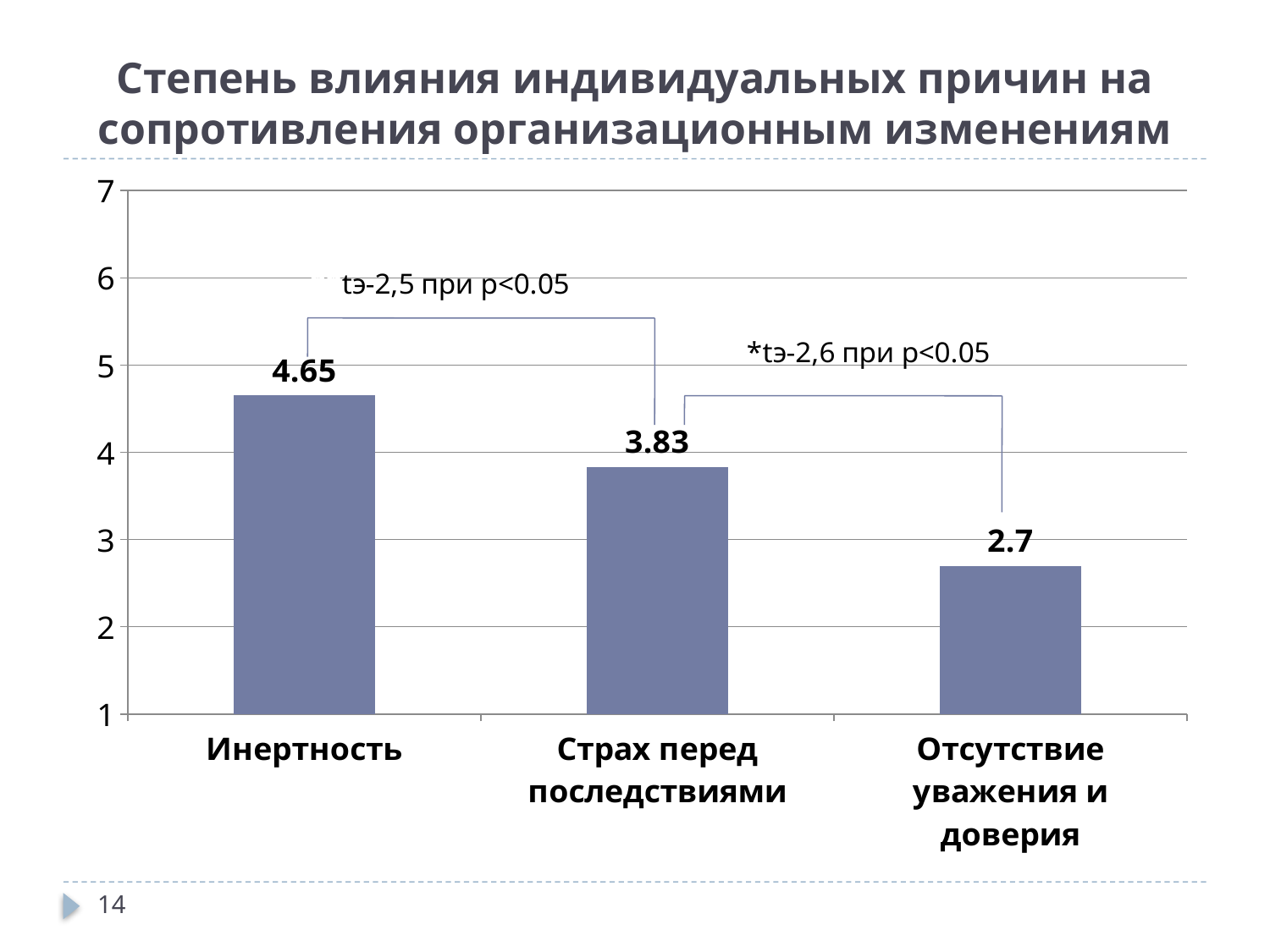
Is the value for Страх перед последствиями greater or less than 4? less How many categories are shown in the chart? 3 Which category has the lowest value? Отсутствие уважения и доверия Which category has the highest value? Инертность What is the value for Инертность? 4.65 What is the value for Отсутствие уважения и доверия? 2.7 What is the value for Страх перед последствиями? 3.83 What is the difference between the values for Инертность and Страх перед последствиями? 0.82 Do the values rise or fall from left to right across the categories? fall What kind of chart is shown on the slide? bar chart Which is larger, the value for Инертность or the value for Отсутствие уважения и доверия? Инертность What is the difference between the values for Страх перед последствиями and Отсутствие уважения и доверия? 1.13